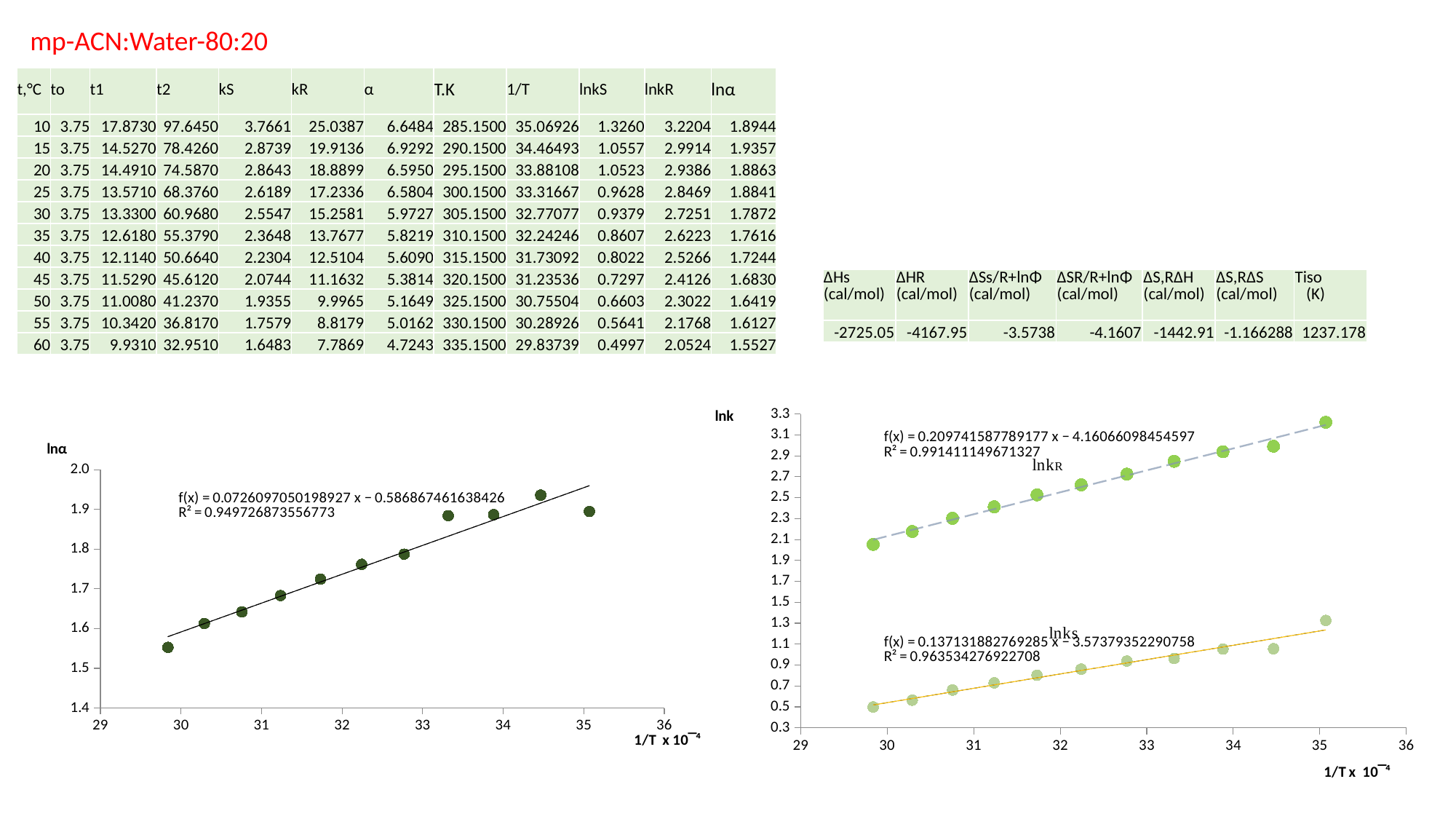
On the left chart (lnα), is the value of the rightmost point (near 1/T = 35) greater or less than 1.8? greater How many data points are plotted on the left chart (lnα)? 11 On the right chart (lnk), which series has the larger values, lnkR or lnkS? lnkR How many data series are plotted on the right chart (lnk)? 2 On the right chart (lnk), does the lnkR series rise or fall as 1/T increases? rise On the right chart (lnk), is the leftmost lnkR point (near 1/T = 30) greater or less than 2.3? less What R² value is shown for the lnkR trendline on the right chart (lnk)? 0.991411149671327 On the left chart (lnα), do the values rise or fall as 1/T increases along the x axis? rise What kind of chart is the left chart (lnα vs 1/T)? scatter chart What R² value is shown for the trendline on the left chart (lnα)? 0.949726873556773 On the left chart (lnα), is the value of the leftmost point (near 1/T = 30) greater or less than 1.6? less